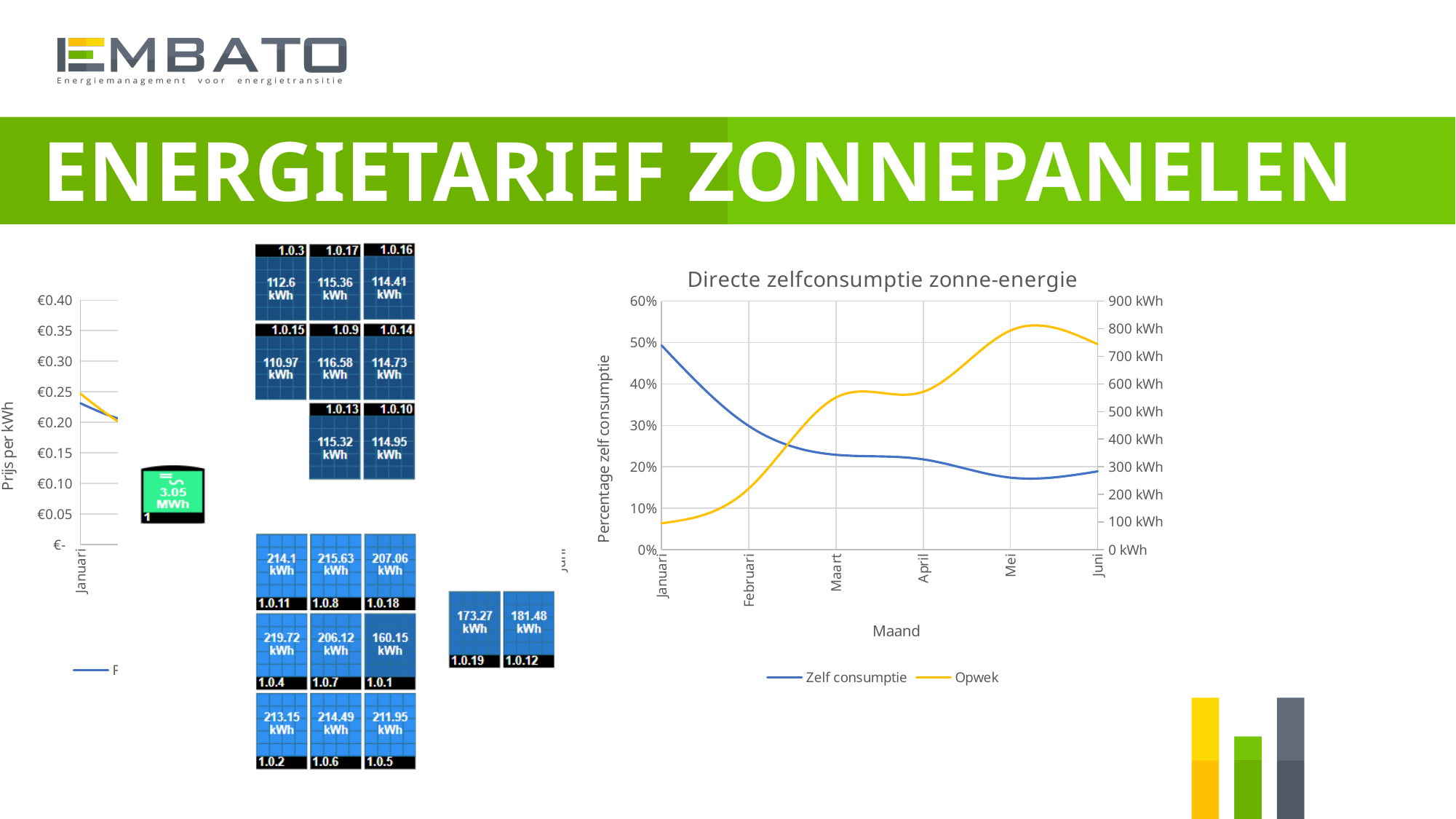
In the 'Directe zelfconsumptie zonne-energie' chart, is the Zelf consumptie value for Maart greater or less than 30%? less In the 'Directe zelfconsumptie zonne-energie' chart, which month has the lowest Opwek value? Januari In the 'Directe zelfconsumptie zonne-energie' chart, is the Opwek value for Mei greater or less than 700 kWh? greater What kind of chart is 'Directe zelfconsumptie zonne-energie'? line chart In the 'Directe zelfconsumptie zonne-energie' chart, which month has the highest Opwek value? Mei How many months are shown on the x axis of the 'Directe zelfconsumptie zonne-energie' chart? 6 What is the title of the chart on the right of the slide? Directe zelfconsumptie zonne-energie What are the two legend entries of the 'Directe zelfconsumptie zonne-energie' chart? Zelf consumptie and Opwek In the 'Directe zelfconsumptie zonne-energie' chart, which month has the highest Zelf consumptie percentage? Januari In the 'Directe zelfconsumptie zonne-energie' chart, is the Opwek value for Januari greater or less than 200 kWh? less How many series does the legend of the 'Directe zelfconsumptie zonne-energie' chart list? 2